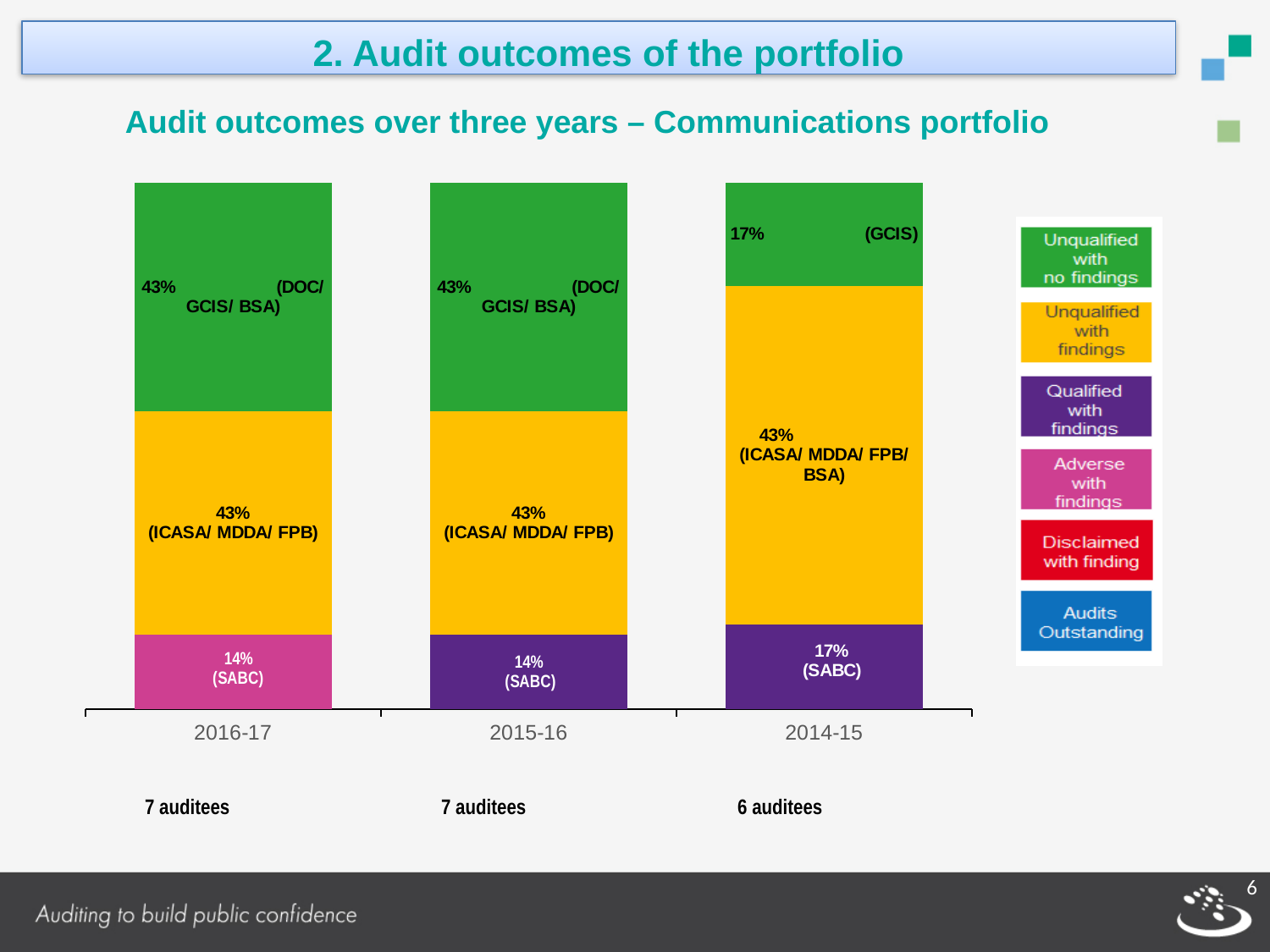
What percentage is shown for the SABC segment in the 2014-15 bar? 17% How many year categories are shown along the x axis of the chart? 3 What percentage of auditees were unqualified with no findings in 2016-17? 43% How many auditees were there in 2014-15? 6 auditees Which year has the larger unqualified with no findings share, 2015-16 or 2014-15? 2015-16 What is the difference between the unqualified with no findings percentage in 2016-17 and in 2014-15? 26% What percentage is shown for the SABC segment in the 2015-16 bar? 14% What percentage of auditees were unqualified with no findings in 2014-15? 17% What type of chart is shown on the slide? Stacked bar chart Which legend entry is shown in red? Disclaimed with finding What is the total of the three segments in the 2016-17 bar? 100% How many entries does the legend of the chart list? 6